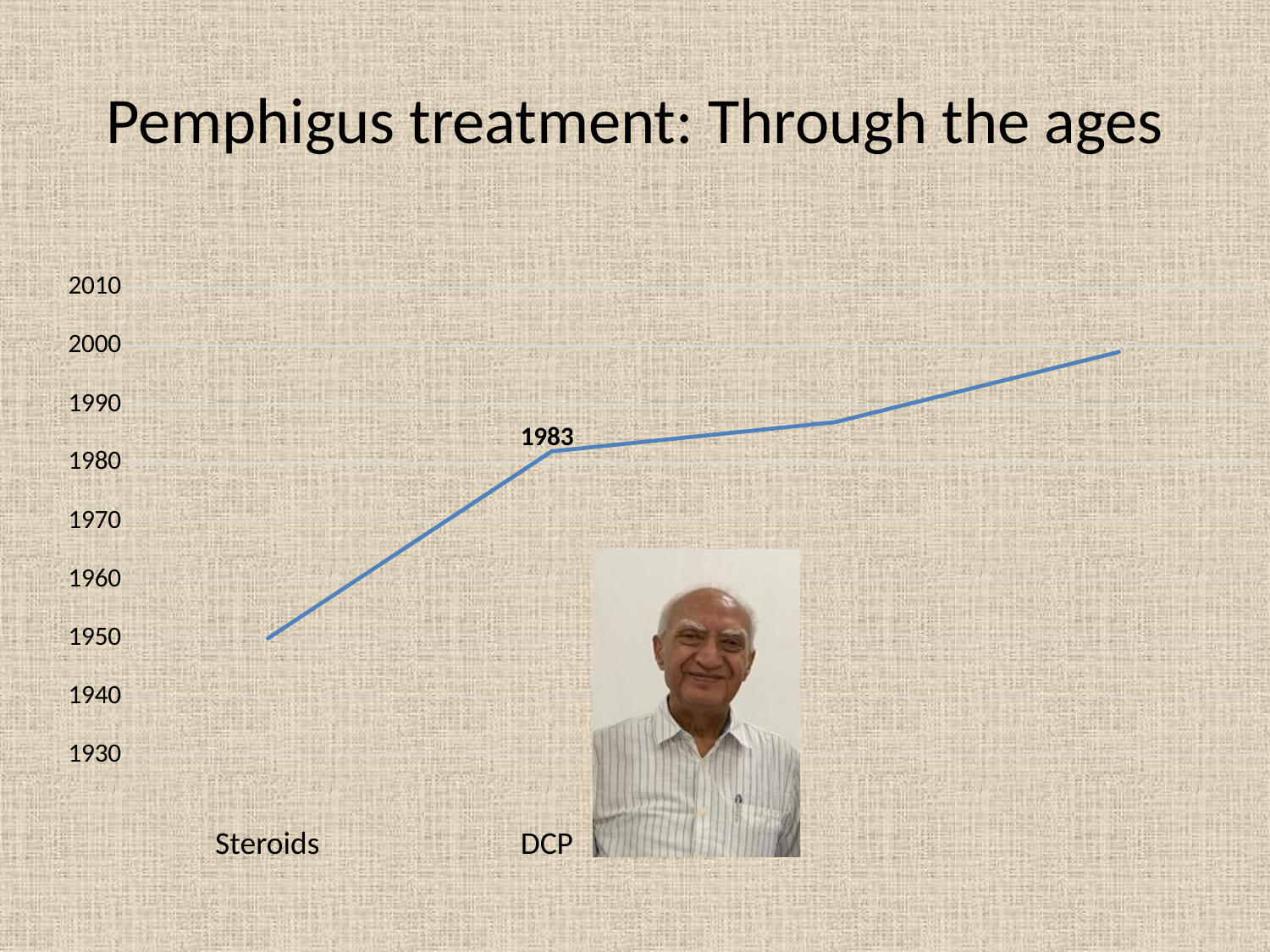
Do the values rise or fall from left to right along the line? rise Is the value of the rightmost point on the line greater or less than 1990? greater Which labelled category has the lowest value on the chart? Steroids Is the value for Steroids greater or less than 1960? less Is the value for DCP greater or less than 1970? greater What is the title of the slide containing the chart? Pemphigus treatment: Through the ages How many years separate the DCP value (1983) from the Steroids value (1950)? 33 Which has the larger value, Steroids or DCP? DCP What year does the Steroids point land on? 1950 What year is labelled for DCP on the chart? 1983 How many points are plotted on the line? 4 What kind of chart is shown on the slide? line chart